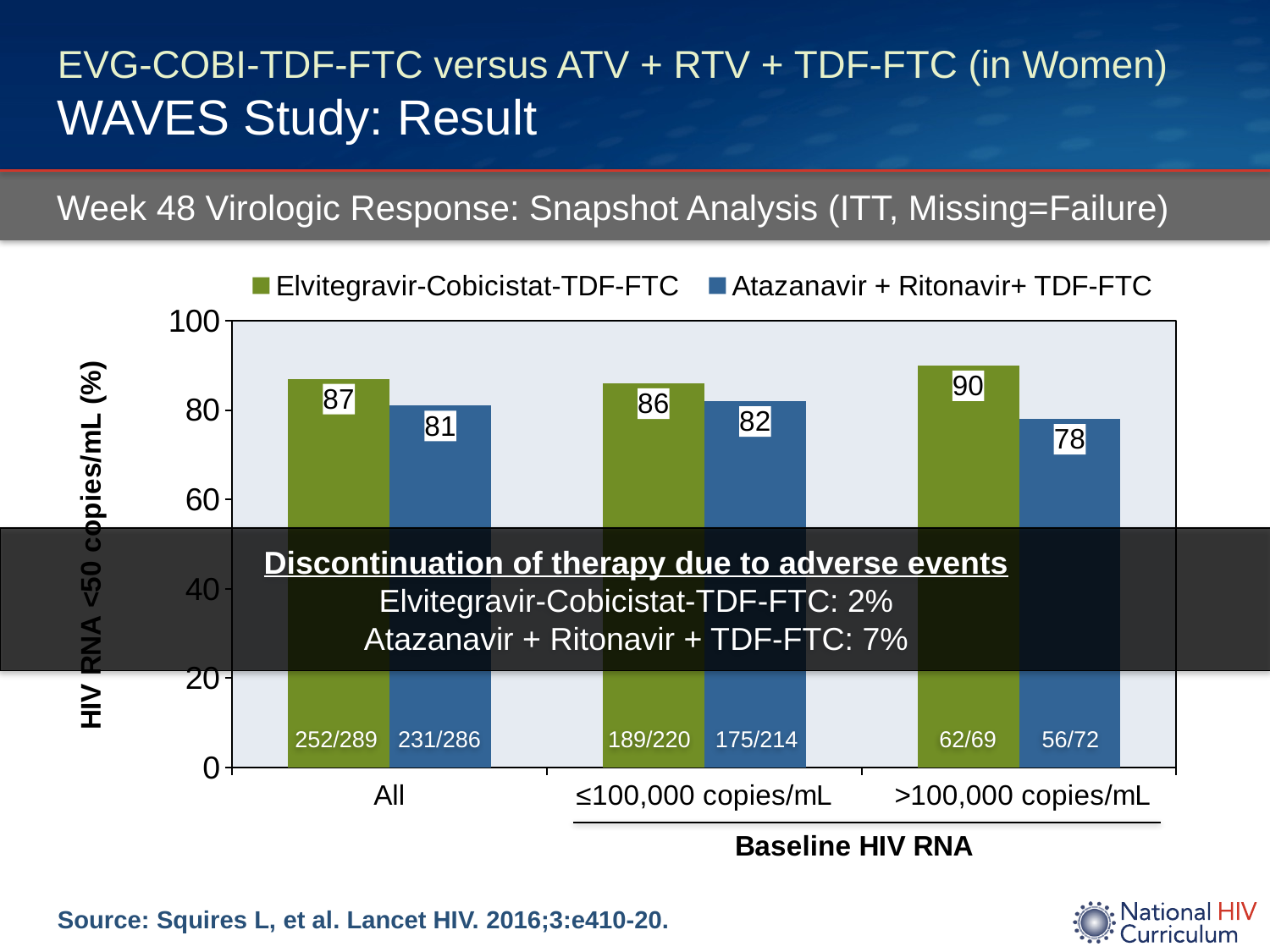
How many series does the legend list? 2 What is the value for Atazanavir + Ritonavir+ TDF-FTC in the >100,000 copies/mL category? 78 Is the value for Atazanavir + Ritonavir+ TDF-FTC in the All category greater or less than 60? greater In the All category, which series has the larger value: Elvitegravir-Cobicistat-TDF-FTC or Atazanavir + Ritonavir+ TDF-FTC? Elvitegravir-Cobicistat-TDF-FTC What is the difference between the Elvitegravir-Cobicistat-TDF-FTC and Atazanavir + Ritonavir+ TDF-FTC values in the >100,000 copies/mL category? 12 What is the value for Elvitegravir-Cobicistat-TDF-FTC in the All category? 87 Which baseline HIV RNA category has the highest value for Elvitegravir-Cobicistat-TDF-FTC? >100,000 copies/mL What kind of chart is shown on the slide? bar chart What is the label of the y axis? HIV RNA <50 copies/mL (%) Which baseline HIV RNA category has the lowest value for Atazanavir + Ritonavir+ TDF-FTC? >100,000 copies/mL What is the value for Atazanavir + Ritonavir+ TDF-FTC in the ≤100,000 copies/mL category? 82 How many baseline HIV RNA categories are shown on the x axis? 3